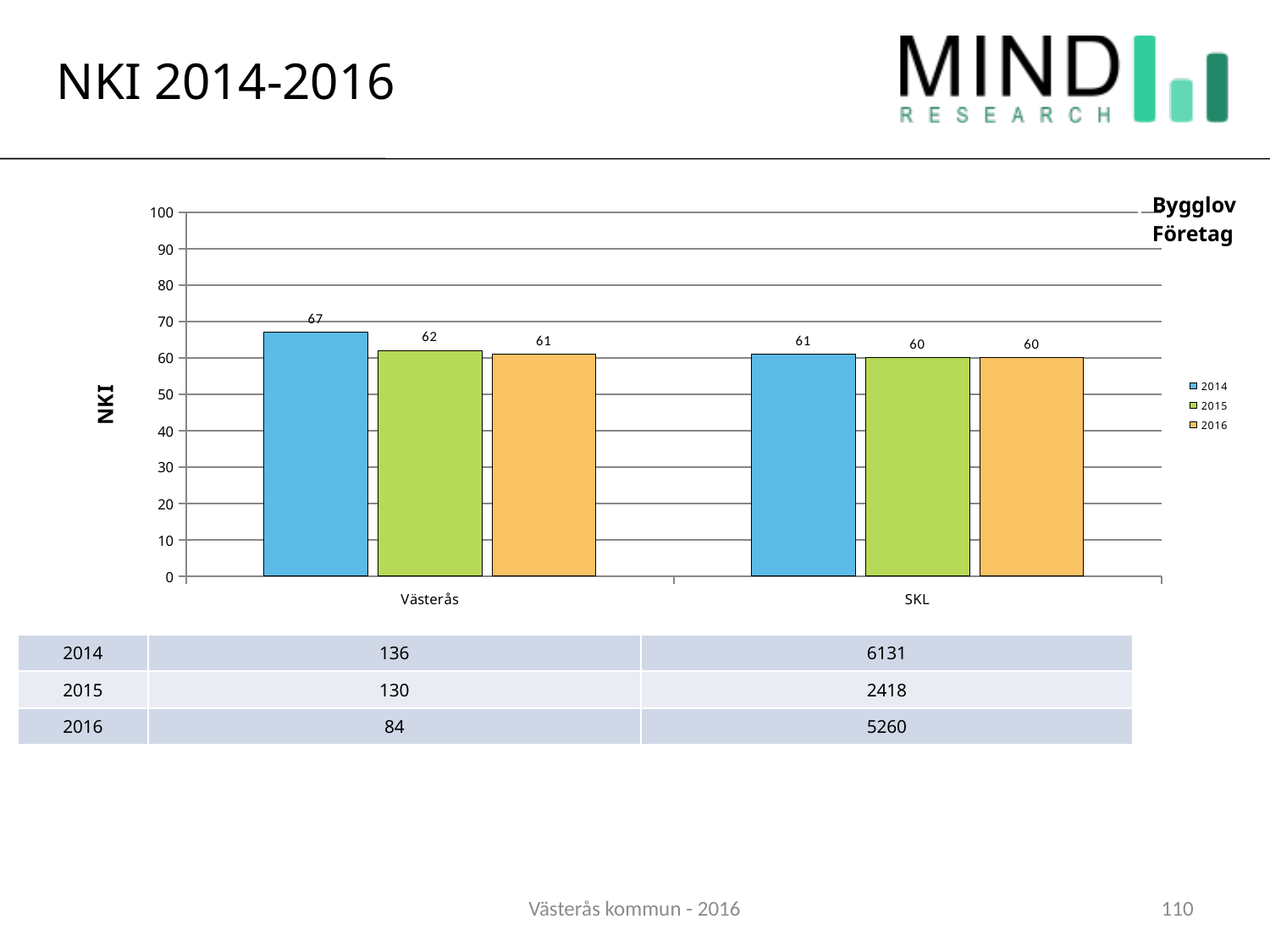
How many categories are shown on the x axis of the chart? 2 Which year has the highest NKI value for Västerås? 2014 Do the NKI values for Västerås rise or fall from 2014 to 2016? fall What is the difference between the Västerås NKI value in 2014 and in 2016? 6 Is the NKI value for Västerås in 2014 greater or less than 60? greater What is the NKI value for Västerås in 2014? 67 Which is larger, the 2015 NKI value for Västerås or the 2015 NKI value for SKL? Västerås What is the NKI value for Västerås in 2016? 61 What is the NKI value for SKL in 2016? 60 How many series does the legend list? 3 What is the label of the y axis of the chart? NKI What kind of chart is shown on the slide? bar chart